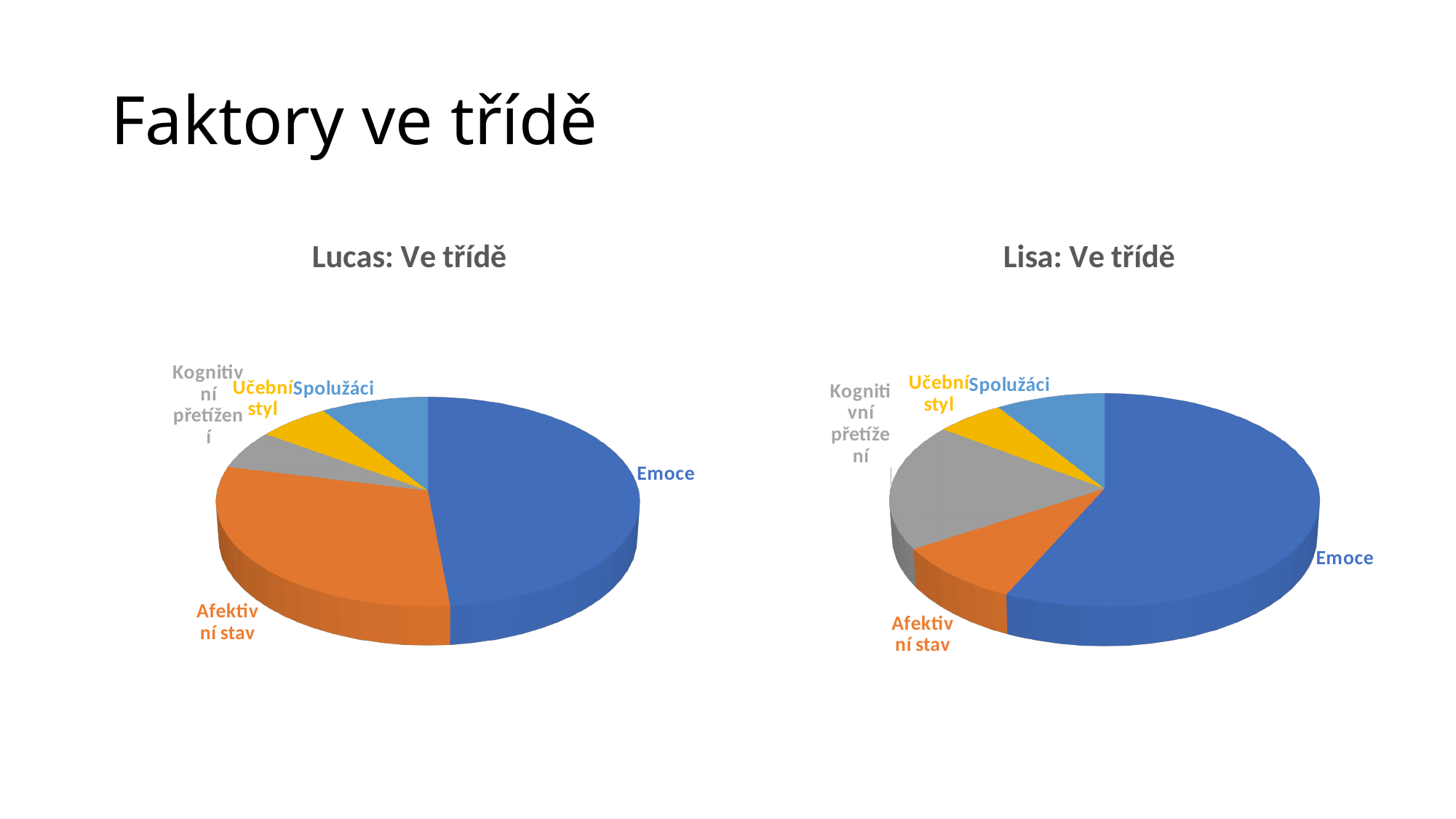
Which chart shows a larger share for Afektivní stav: "Lucas: Ve třídě" or "Lisa: Ve třídě"? Lucas: Ve třídě What kind of chart is the "Lucas: Ve třídě" chart? pie chart In the "Lisa: Ve třídě" chart, which category has the largest slice? Emoce How many slices does the "Lucas: Ve třídě" pie chart have? 5 What is the title of the pie chart on the right side of the slide? Lisa: Ve třídě In the "Lucas: Ve třídě" chart, what colour is the Emoce slice? blue In the "Lisa: Ve třídě" chart, which slice is larger: Kognitivní přetížení or Afektivní stav? Kognitivní přetížení How many slices does the "Lisa: Ve třídě" pie chart have? 5 In the "Lucas: Ve třídě" chart, which slice is larger: Afektivní stav or Spolužáci? Afektivní stav In the "Lucas: Ve třídě" chart, which category has the largest slice? Emoce What kind of chart is the "Lisa: Ve třídě" chart? pie chart